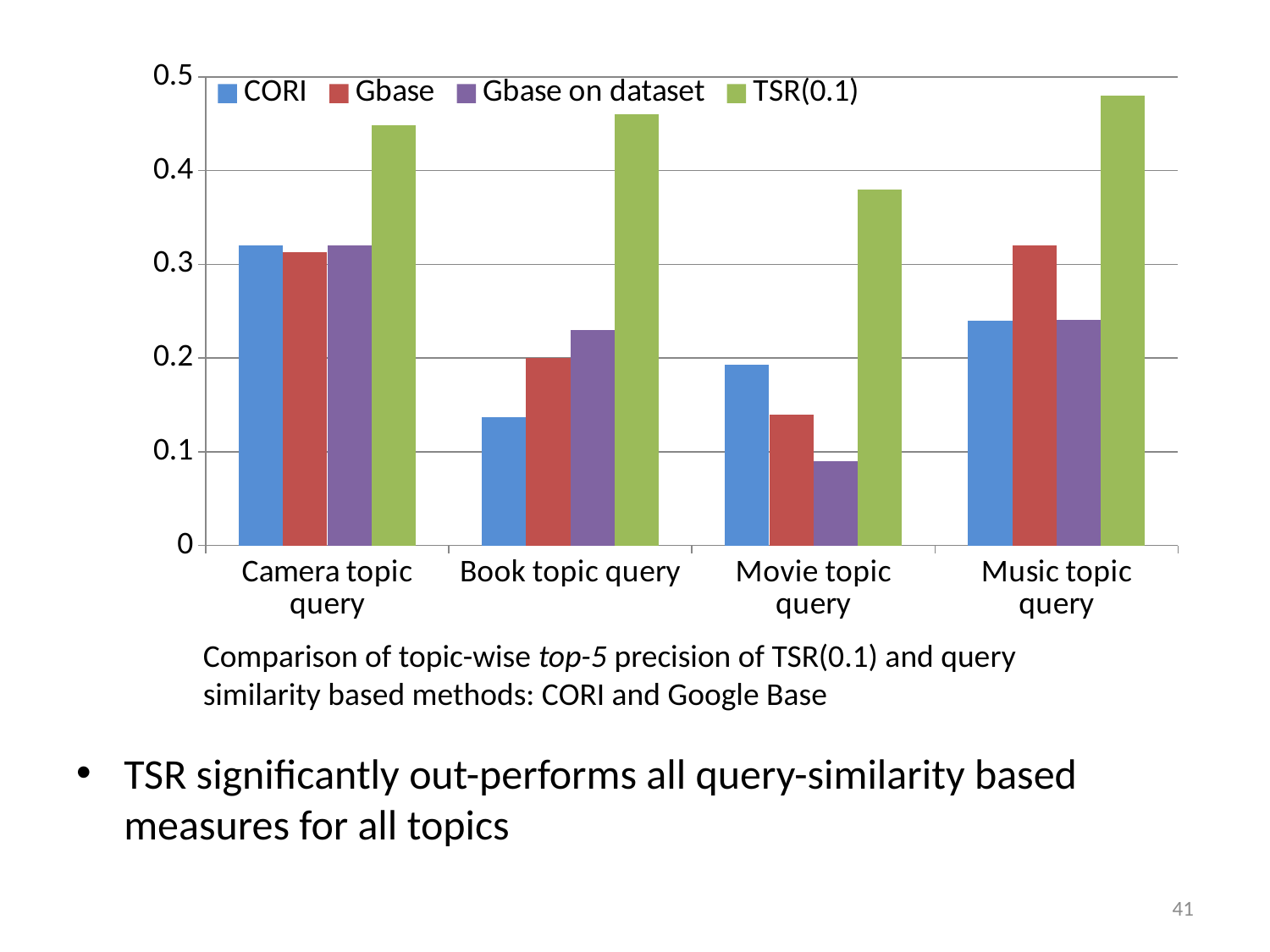
Is the TSR(0.1) value for Camera topic query greater or less than 0.4? greater What kind of chart is shown on the slide? bar chart What colour represents TSR(0.1) in the chart? green For Music topic query, which is larger: CORI or Gbase? Gbase Which category has the lowest CORI value? Book topic query Which category has the lowest TSR(0.1) value? Movie topic query Is the CORI value for Book topic query greater or less than 0.2? less How many topic query categories are shown on the x axis? 4 How many series does the legend list? 4 Is the TSR(0.1) value for Movie topic query greater or less than 0.4? less For Movie topic query, which series has the highest value? TSR(0.1) For Movie topic query, which series has the lowest value? Gbase on dataset